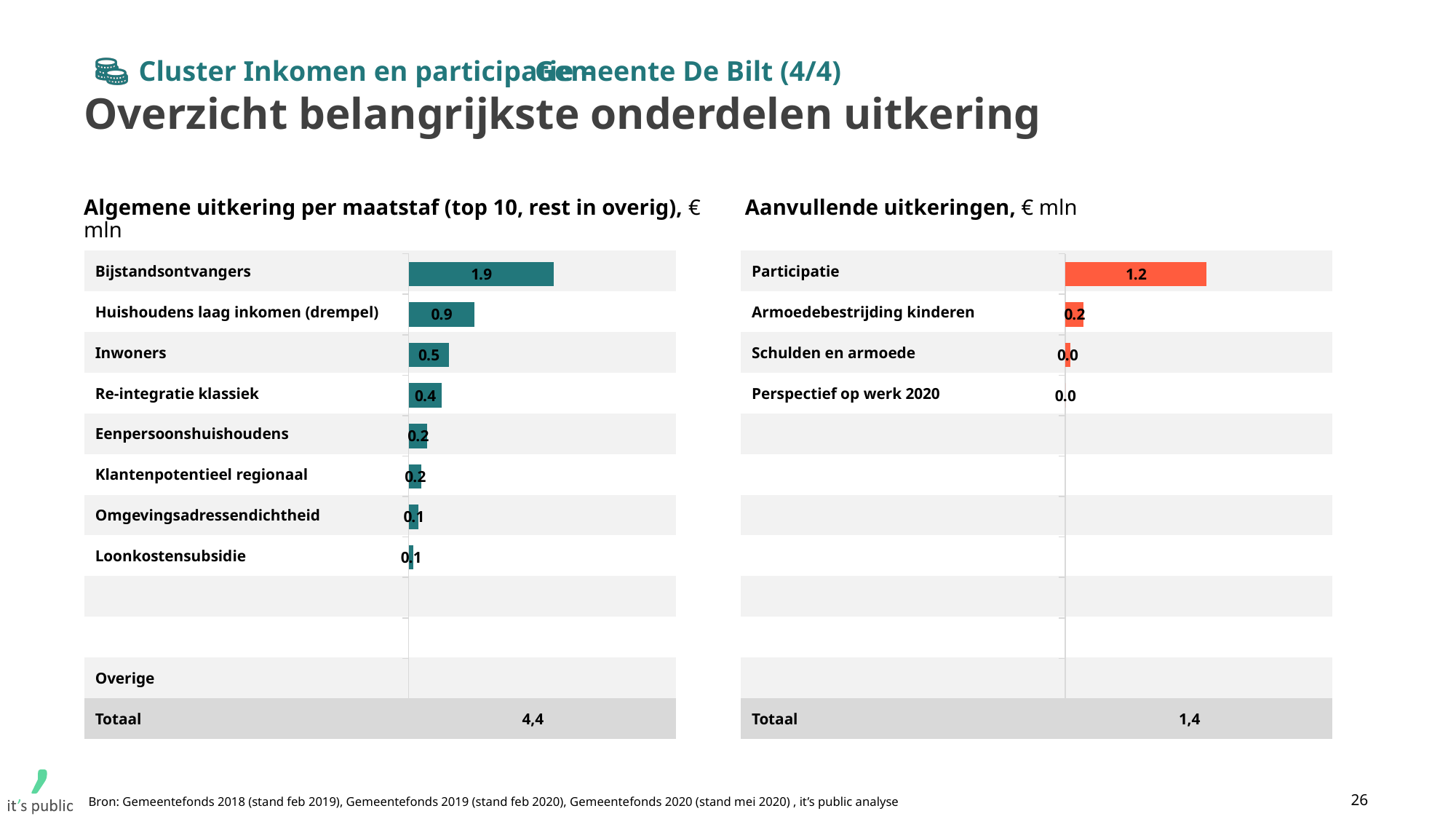
In the chart 'Algemene uitkering per maatstaf', what is the value for Bijstandsontvangers? 1.9 In the chart 'Algemene uitkering per maatstaf', which category has the highest value? Bijstandsontvangers In the chart 'Aanvullende uitkeringen', what is the difference between Participatie and Armoedebestrijding kinderen? 1.0 In the chart 'Algemene uitkering per maatstaf', what is the Totaal value shown? 4,4 In the chart 'Algemene uitkering per maatstaf', what is the difference between Bijstandsontvangers and Huishoudens laag inkomen (drempel)? 1.0 In the chart 'Algemene uitkering per maatstaf', which is larger: Inwoners or Re-integratie klassiek? Inwoners In the chart 'Aanvullende uitkeringen', what is the value for Armoedebestrijding kinderen? 0.2 In the chart 'Aanvullende uitkeringen', what is the Totaal value shown? 1,4 In the chart 'Algemene uitkering per maatstaf', what is the value for Huishoudens laag inkomen (drempel)? 0.9 What kind of chart is the 'Aanvullende uitkeringen' chart? Bar chart In the chart 'Aanvullende uitkeringen', what is the value for Participatie? 1.2 In the chart 'Aanvullende uitkeringen', which category has the highest value? Participatie